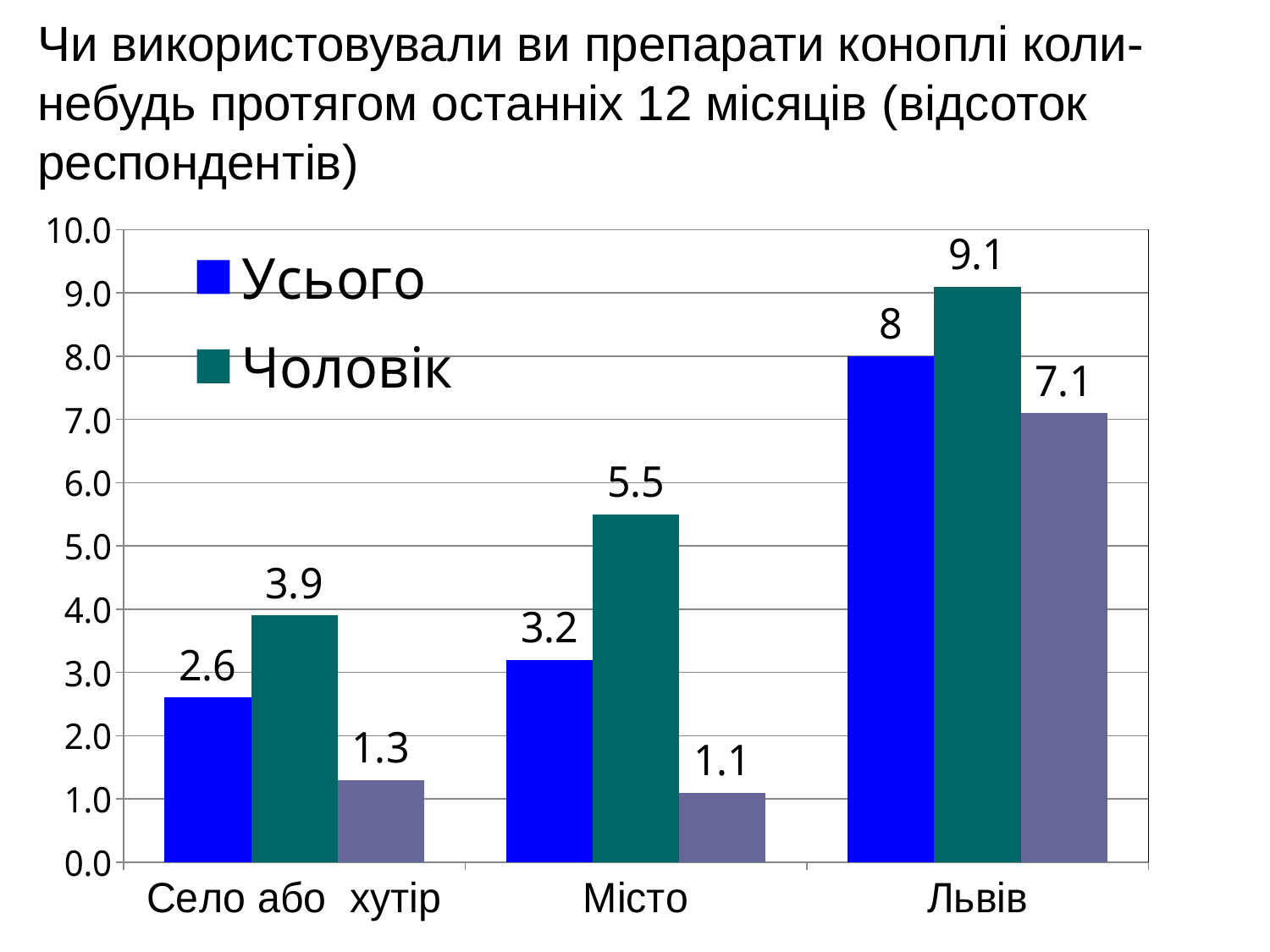
Which category has the lowest value for Усього? Село або хутір Is the value for Усього in Місто greater or less than 3.0? greater How many categories are shown on the x axis? 3 What is the value for Чоловік in Місто? 5.5 How many series does the legend list? 2 Which is larger: the Чоловік value in Місто or the Чоловік value in Село або хутір? Місто What is the value for Чоловік in Село або хутір? 3.9 What is the difference between the Чоловік and Усього values in Львів? 1.1 What kind of chart is shown on the slide? bar chart Which category has the highest value for Чоловік? Львів What is the value for Усього in Львів? 8 What is the value for Усього in Село або хутір? 2.6